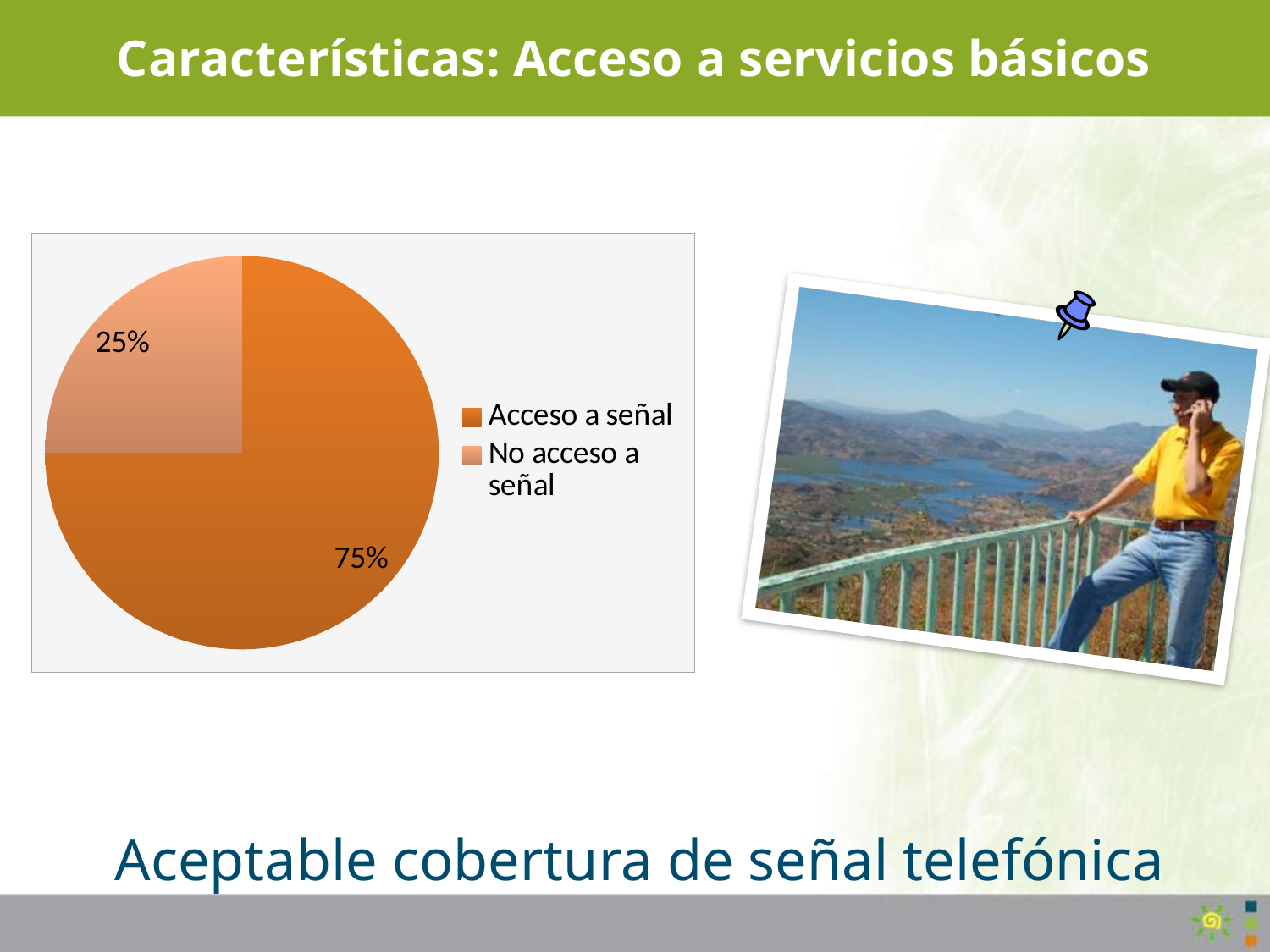
What share of the pie does "No acceso a señal" represent? 25% Which legend entry corresponds to the lighter orange slice? No acceso a señal How many entries does the legend list? 2 What is the difference in percentage points between "Acceso a señal" and "No acceso a señal"? 50% Which slice of the pie is the largest? Acceso a señal What share of the pie does "Acceso a señal" represent? 75% What is the title of the slide containing the pie chart? Características: Acceso a servicios básicos How many slices does the pie chart have? 2 What kind of chart is shown on the slide? pie chart What is the value printed on the darker orange slice? 75% Which is larger, the "Acceso a señal" slice or the "No acceso a señal" slice? Acceso a señal Which slice of the pie is the smallest? No acceso a señal